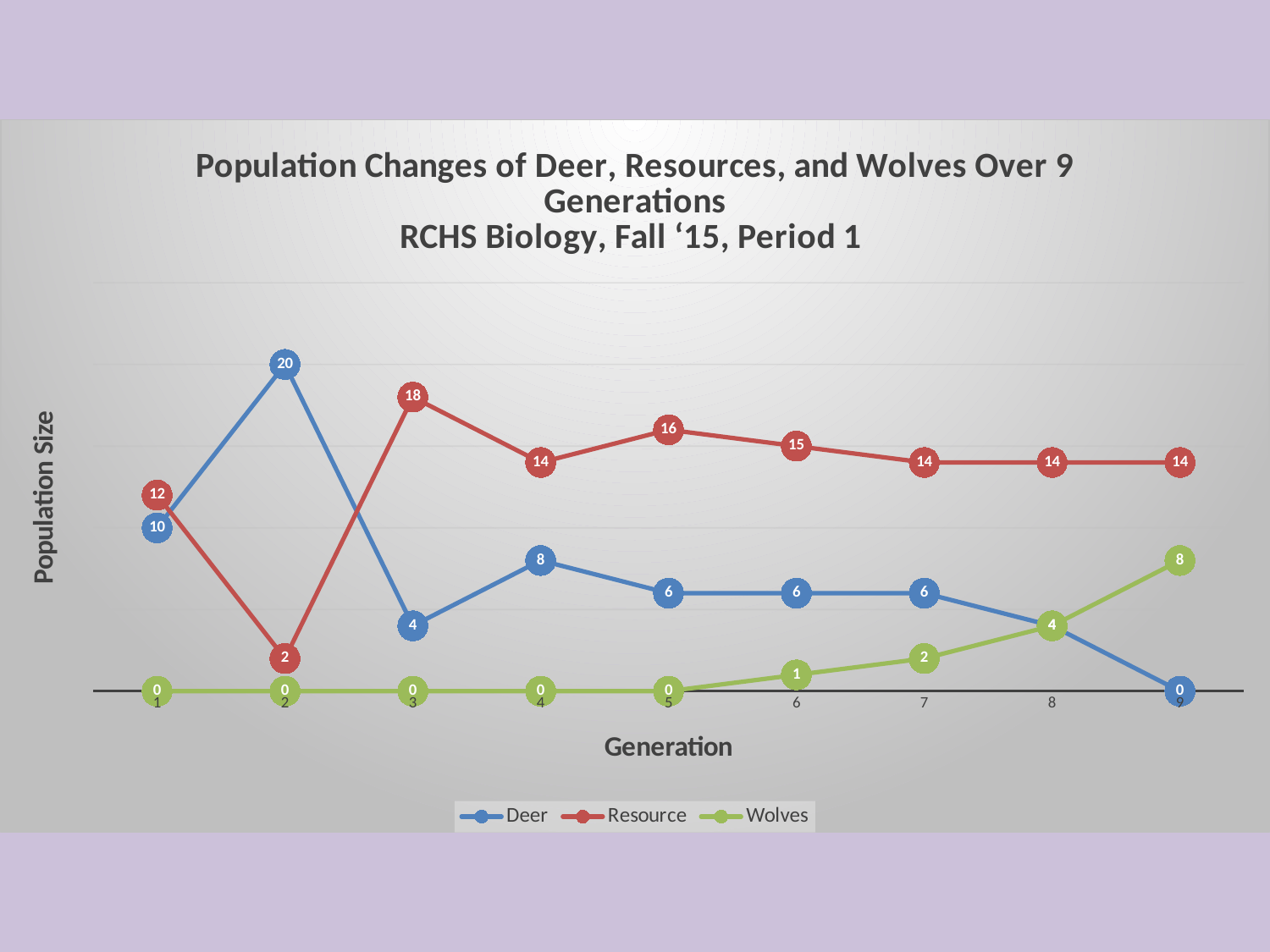
At generation 5, which is larger: the Resource value or the Deer population? Resource What kind of chart is shown on the slide? line chart What is the Resource value at generation 3? 18 At generation 1, how much larger is the Resource value than the Deer population? 2 Does the Wolves population rise or fall from generation 5 to generation 9? rise What is the Wolves population at generation 9? 8 How many series does the legend list? 3 At which generation is the Resource value lowest? 2 What is the Deer population at generation 2? 20 What is the title of the x axis? Generation How many generations are plotted along the x axis? 9 At which generation is the Deer population highest? 2